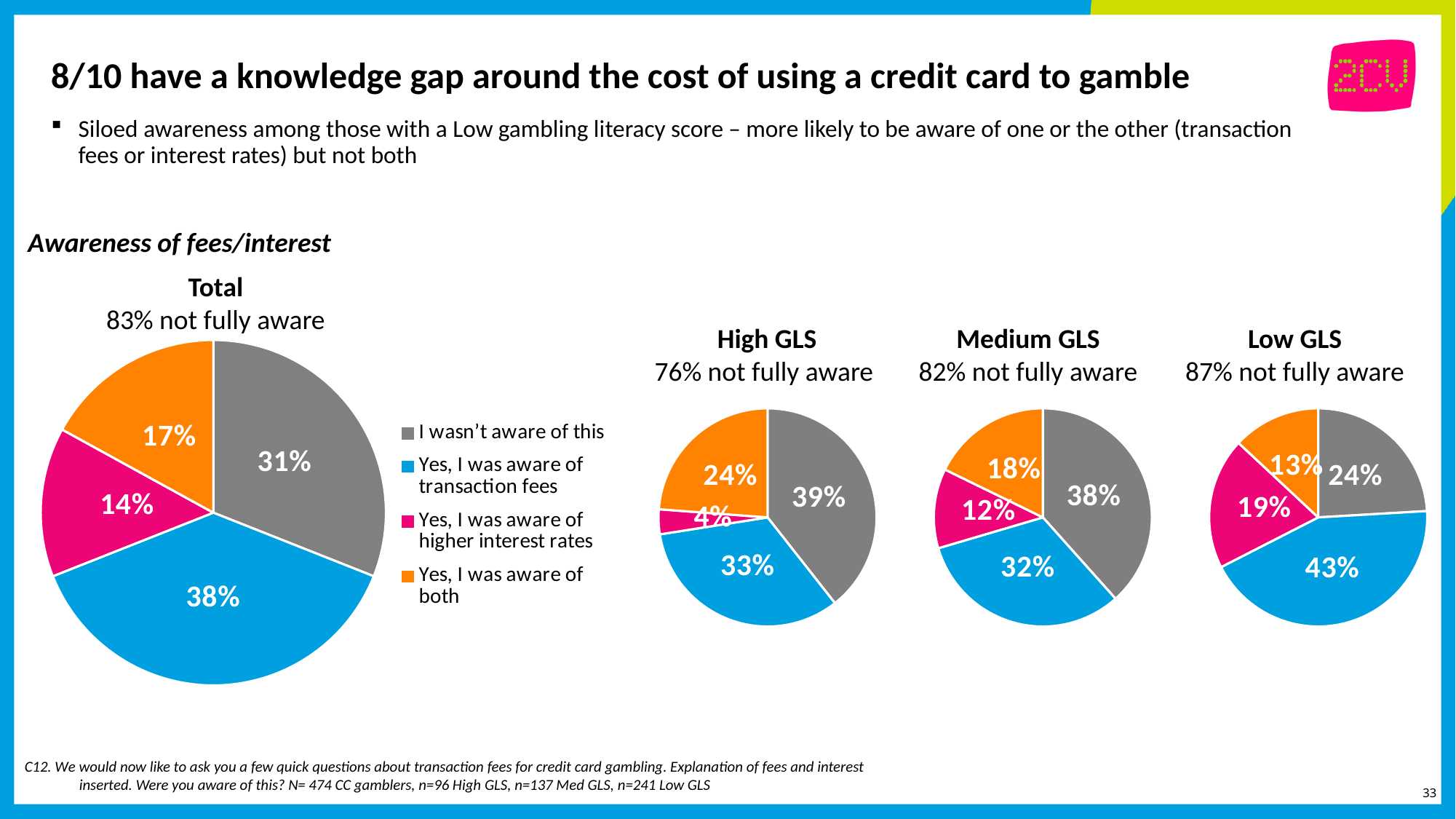
How many slices does the Medium GLS pie chart have? 4 In the Total pie chart, what share were aware of transaction fees? 38% According to the subtitle above the Low GLS pie chart, what percentage are not fully aware? 87% In the High GLS pie chart, which category has the smallest share? Yes, I was aware of higher interest rates In the Medium GLS pie chart, which category has the largest share? I wasn't aware of this In the Low GLS pie chart, what share were aware of both? 13% In the High GLS pie chart, what share were aware of higher interest rates? 4% How many entries does the legend list? 4 In the Total pie chart, what share of respondents said 'I wasn't aware of this'? 31% In the Low GLS pie chart, what is the difference between the share aware of transaction fees and the share aware of higher interest rates? 24% In the Total pie chart, which is larger: the share aware of both or the share aware of higher interest rates? Yes, I was aware of both What kind of chart is used to show awareness of fees/interest for the Total group? Pie chart